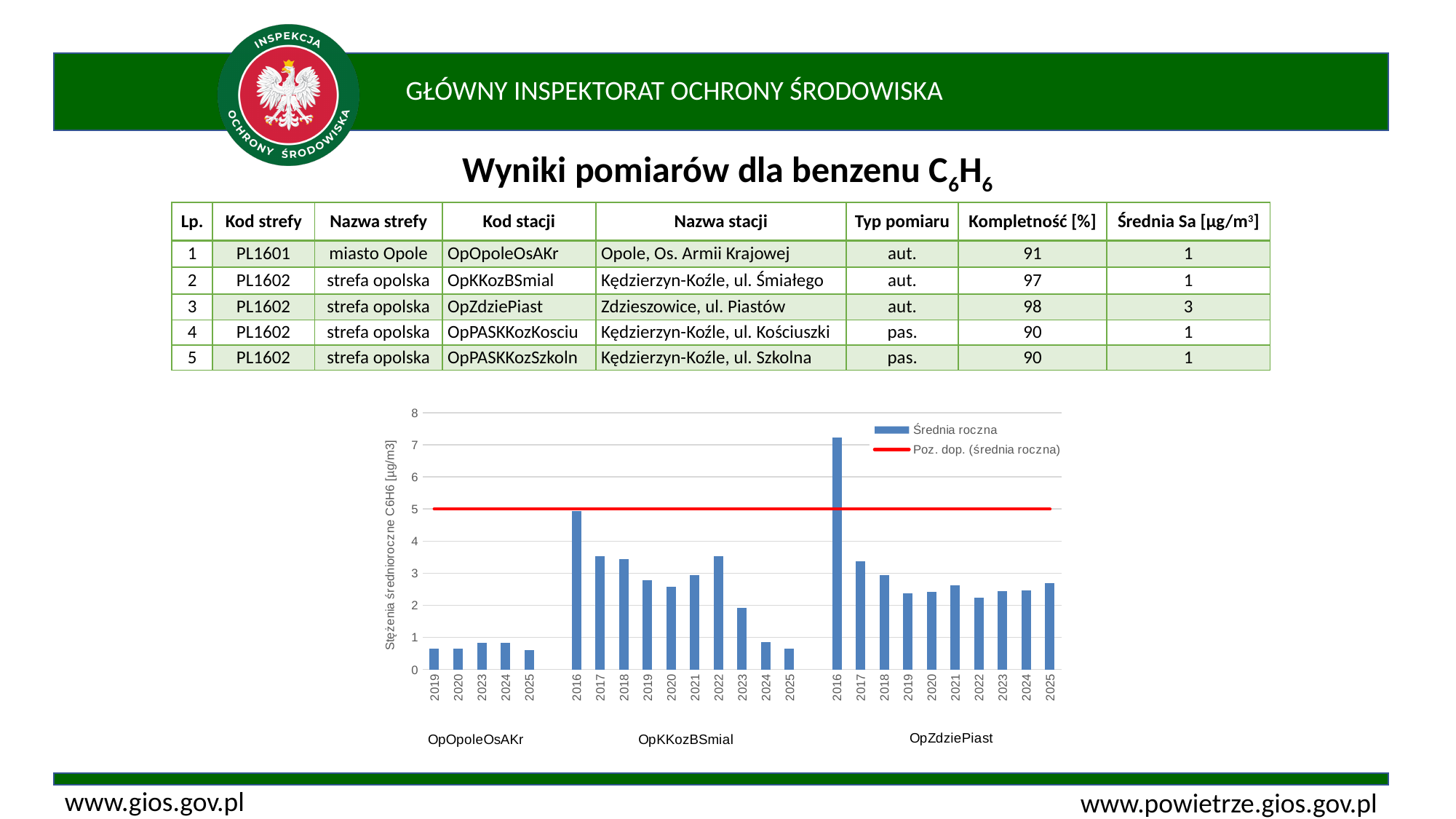
How many yearly bars are plotted for the station OpKKozBSmial? 10 How many yearly bars are plotted for the station OpOpoleOsAKr? 5 At what level on the y axis is the red 'Poz. dop. (średnia roczna)' line drawn? 5 How many series does the chart legend list? 2 Which is larger: the 2022 bar or the 2023 bar for OpKKozBSmial? 2022 Which station and year has the highest annual average bar in the chart? OpZdziePiast, 2016 Is the value for OpZdziePiast in 2016 greater or less than 5? greater How many stations are shown along the x axis of the chart? 3 Is the value for OpOpoleOsAKr in 2023 greater or less than 1? less What kind of chart is shown on the slide? combination bar and line chart Do the bars for OpZdziePiast rise or fall from 2016 to 2019? fall Is the value for OpKKozBSmial in 2017 greater or less than 3? greater